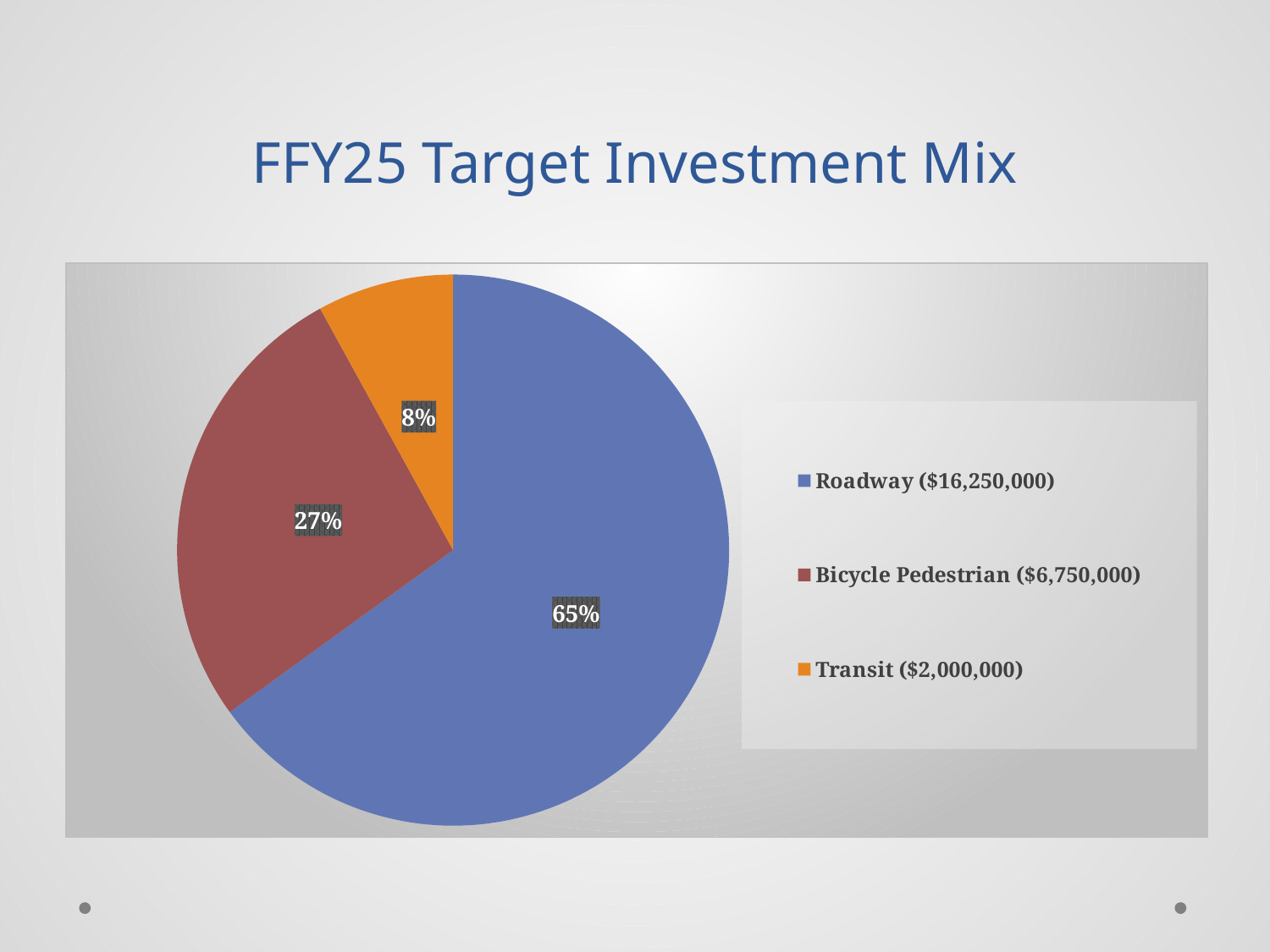
What share of the pie does Roadway represent? 65% Which category has the largest slice of the pie? Roadway Which category has the smallest slice of the pie? Transit What kind of chart is shown on the slide? pie chart What is the title of the chart? FFY25 Target Investment Mix How many entries does the legend list? 3 What share of the pie does Bicycle Pedestrian represent? 27% Which slice is larger, Bicycle Pedestrian or Transit? Bicycle Pedestrian What dollar amount does the legend show for Transit? $2,000,000 What is the difference in percentage points between the Roadway and Bicycle Pedestrian slices? 38 What share of the pie does Transit represent? 8% How many slices does the pie chart have? 3